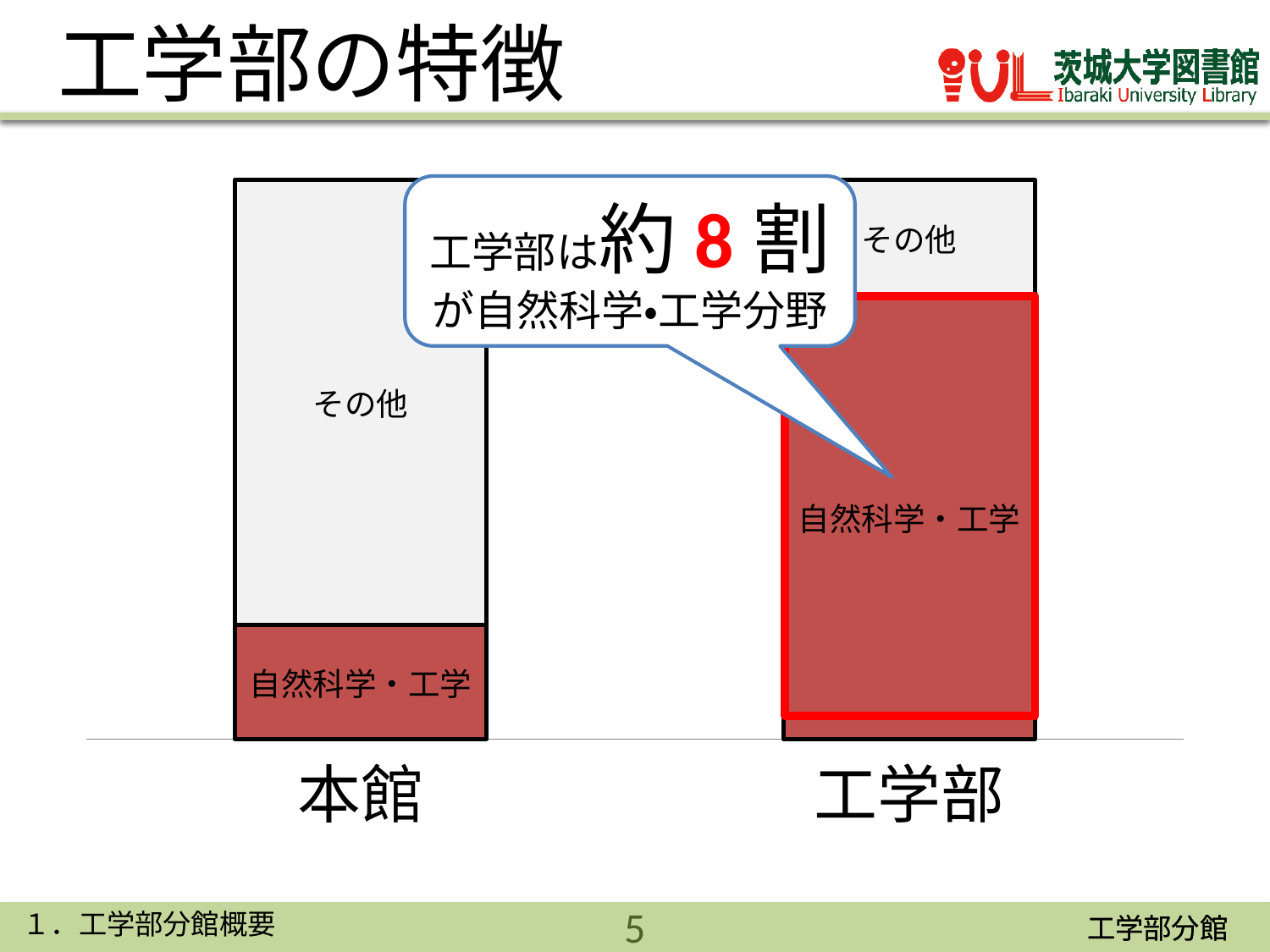
What kind of chart is shown on the slide? Stacked bar chart Which segment is larger in the 本館 bar, その他 or 自然科学・工学? その他 Which bar has the larger その他 segment, 本館 or 工学部? 本館 What colour is used for the 自然科学・工学 segment in the chart? Red How many bars (categories) does the chart show? 2 Which category has the highest share of 自然科学・工学? 工学部 What is the title of the slide containing the chart? 工学部の特徴 Which segment is larger in the 工学部 bar, その他 or 自然科学・工学? 自然科学・工学 Which category has the lowest share of 自然科学・工学? 本館 What are the two categories labelled along the bottom of the chart? 本館 and 工学部 How many segments (series) make up each stacked bar? 2